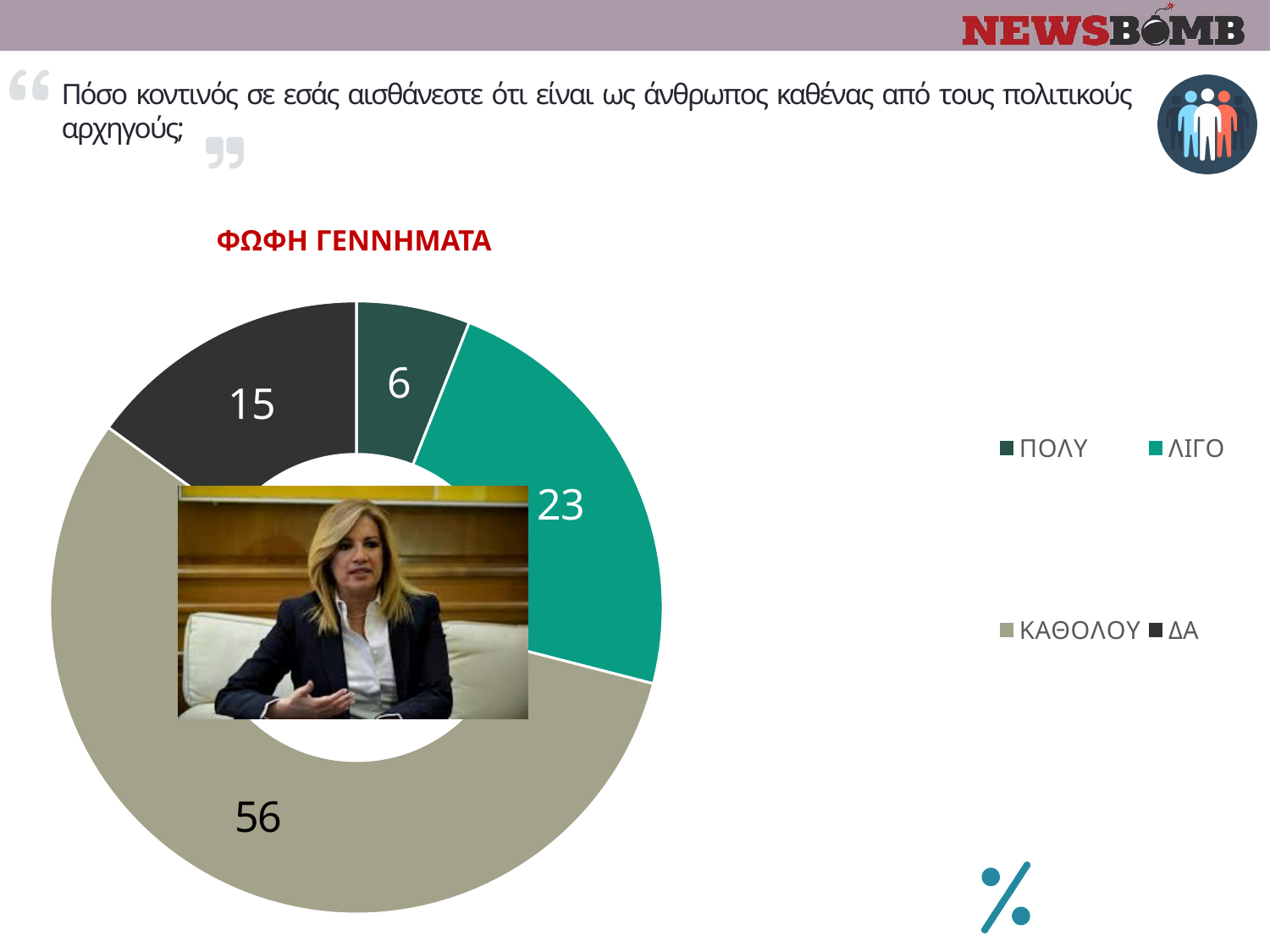
What value is shown for ΛΙΓΟ in the ΦΩΦΗ ΓΕΝΝΗΜΑΤΑ chart? 23 Which is larger in the ΦΩΦΗ ΓΕΝΝΗΜΑΤΑ chart, ΔΑ or ΠΟΛΥ? ΔΑ Which legend entry is shown in teal in the ΦΩΦΗ ΓΕΝΝΗΜΑΤΑ chart? ΛΙΓΟ What is the combined value of ΠΟΛΥ and ΛΙΓΟ in the ΦΩΦΗ ΓΕΝΝΗΜΑΤΑ chart? 29 Which category has the smallest share in the ΦΩΦΗ ΓΕΝΝΗΜΑΤΑ chart? ΠΟΛΥ What value is shown for ΔΑ in the ΦΩΦΗ ΓΕΝΝΗΜΑΤΑ chart? 15 Which category has the largest share in the ΦΩΦΗ ΓΕΝΝΗΜΑΤΑ chart? ΚΑΘΟΛΟΥ What value is shown for ΚΑΘΟΛΟΥ in the ΦΩΦΗ ΓΕΝΝΗΜΑΤΑ chart? 56 How many categories does the ΦΩΦΗ ΓΕΝΝΗΜΑΤΑ chart show? 4 What is the difference between the ΚΑΘΟΛΟΥ and ΛΙΓΟ values in the ΦΩΦΗ ΓΕΝΝΗΜΑΤΑ chart? 33 What value is shown for ΠΟΛΥ in the ΦΩΦΗ ΓΕΝΝΗΜΑΤΑ chart? 6 What kind of chart is used for ΦΩΦΗ ΓΕΝΝΗΜΑΤΑ? Doughnut chart